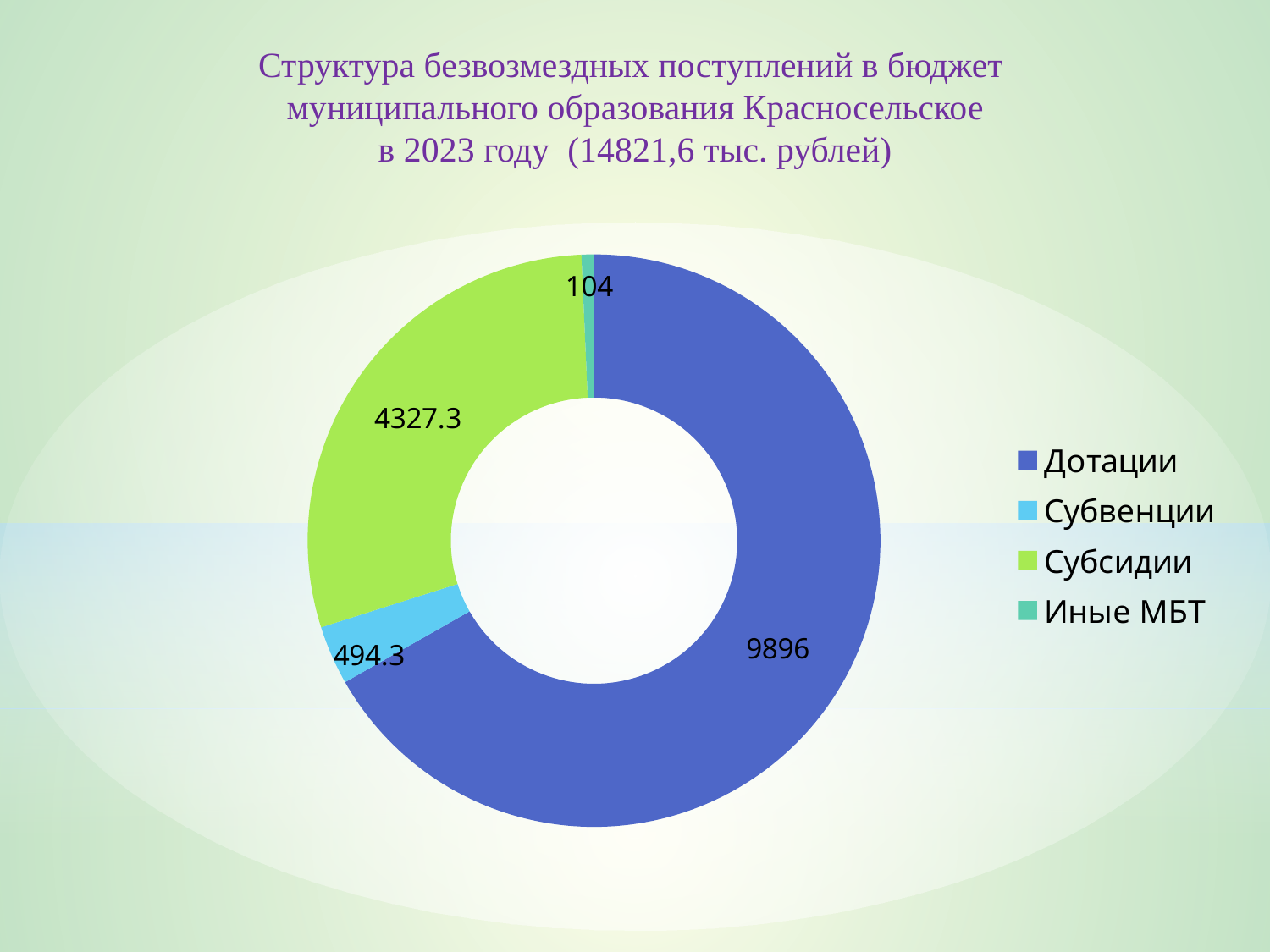
What is the value for Субвенции? 494.3 What is the difference between the values for Дотации and Субсидии? 5568.7 Which category has the largest value? Дотации What kind of chart is shown on the slide? Doughnut (pie) chart What is the value for Иные МБТ? 104 What is the difference between the values for Субвенции and Иные МБТ? 390.3 How many categories does the chart show? 4 What is the value for Дотации? 9896 What is the value for Субсидии? 4327.3 Which category has the smallest value? Иные МБТ Which is larger, the value for Субсидии or the value for Субвенции? Субсидии What is the total of all the values shown in the chart? 14821.6